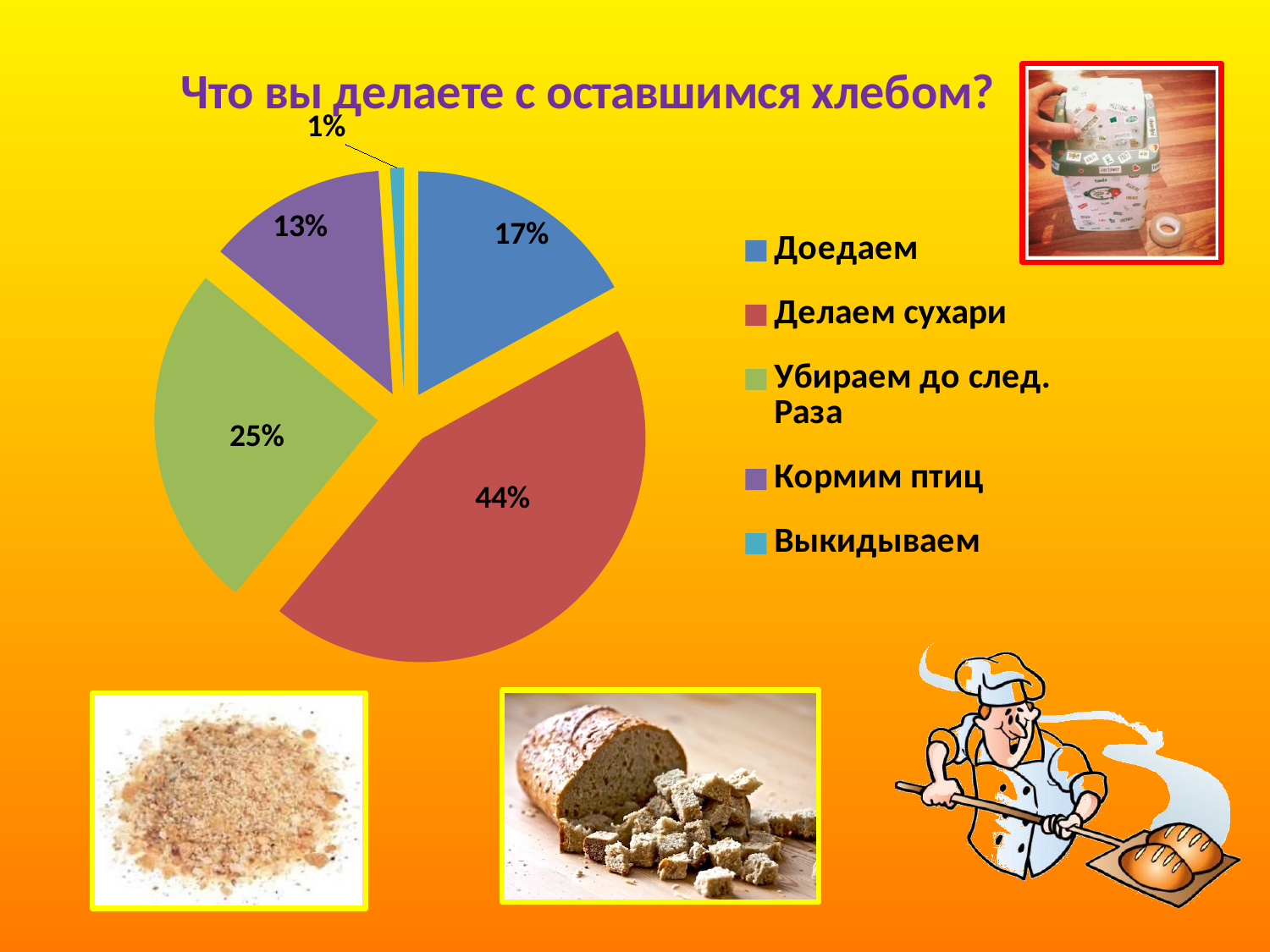
What percentage of respondents answered "Убираем до след. Раза"? 25% What percentage of respondents answered "Делаем сухари"? 44% Which category has the smallest share of the pie? Выкидываем What percentage of respondents answered "Доедаем"? 17% Which category has the largest share of the pie? Делаем сухари What percentage of respondents answered "Кормим птиц"? 13% Which is larger: the share for "Доедаем" or the share for "Кормим птиц"? Доедаем What percentage of respondents answered "Выкидываем"? 1% What type of chart is shown on the slide? pie chart What is the difference in percentage points between "Делаем сухари" and "Убираем до след. Раза"? 19 How many categories does the legend list? 5 What is the title of the chart? Что вы делаете с оставшимся хлебом?